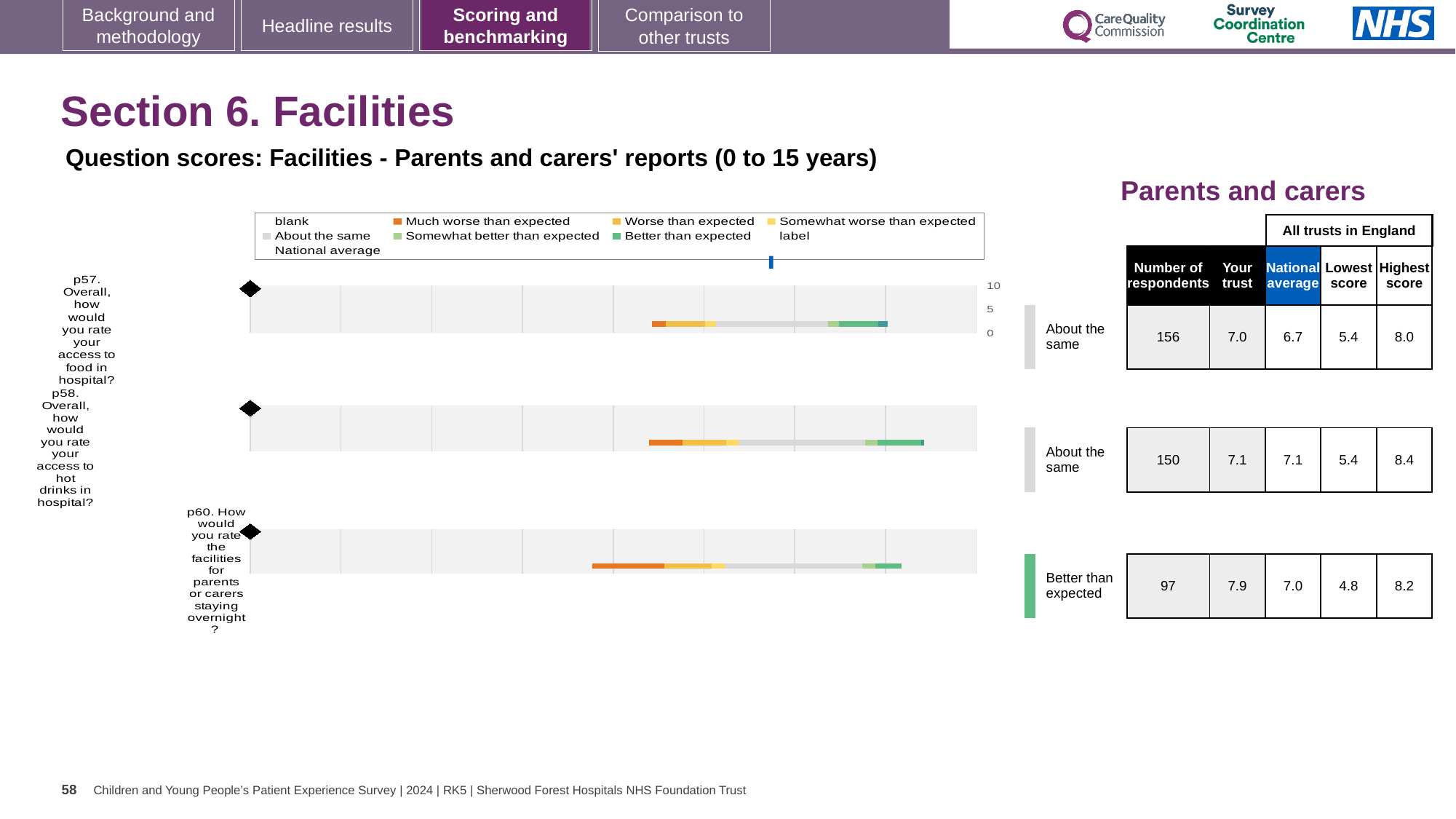
How many respondents answered p57 (access to food in hospital)? 156 Which question has the highest 'Your trust' score? p60 (facilities for parents or carers staying overnight) For p60, how much higher is the 'Your trust' score than the national average? 0.9 What is the 'Your trust' score for p57 (access to food in hospital)? 7.0 Which question has the lowest 'Lowest score' across all trusts in England? p60 (facilities for parents or carers staying overnight) Is the 'Your trust' score for p58 greater or less than 5? greater What is the national average score for p58 (access to hot drinks in hospital)? 7.1 What kind of chart is used to show the question scores on this slide? Bar chart How many survey questions are plotted in the Facilities charts on this slide? 3 What is the highest score among all trusts in England for p60 (facilities for parents or carers staying overnight)? 8.2 For p57, which is larger: the 'Your trust' score or the national average? Your trust Which benchmark category is p60 (facilities for parents or carers staying overnight) placed in? Better than expected